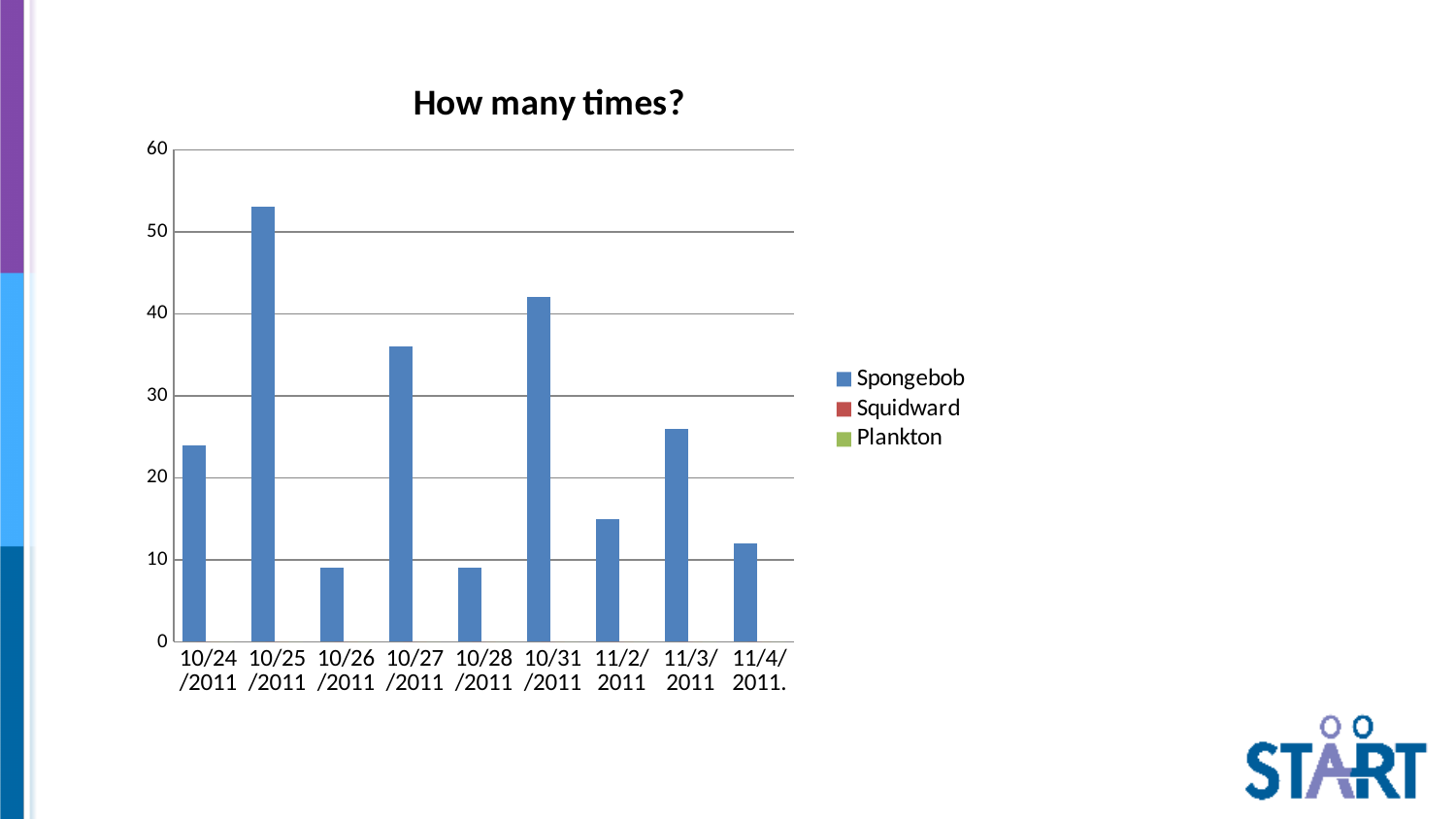
What kind of chart is shown on the slide? bar chart Is the Spongebob value for 10/31/2011 greater or less than 40? greater What is the title of the chart? How many times? On which date is the Spongebob bar highest? 10/25/2011 Which series are listed in the chart's legend? Spongebob, Squidward, Plankton How many dates are shown along the x axis of the chart? 9 How many series does the legend list? 3 Is the Spongebob value for 10/27/2011 greater or less than 30? greater Is the Spongebob value for 11/2/2011 greater or less than 20? less Which has the larger Spongebob value, 10/27/2011 or 10/31/2011? 10/31/2011